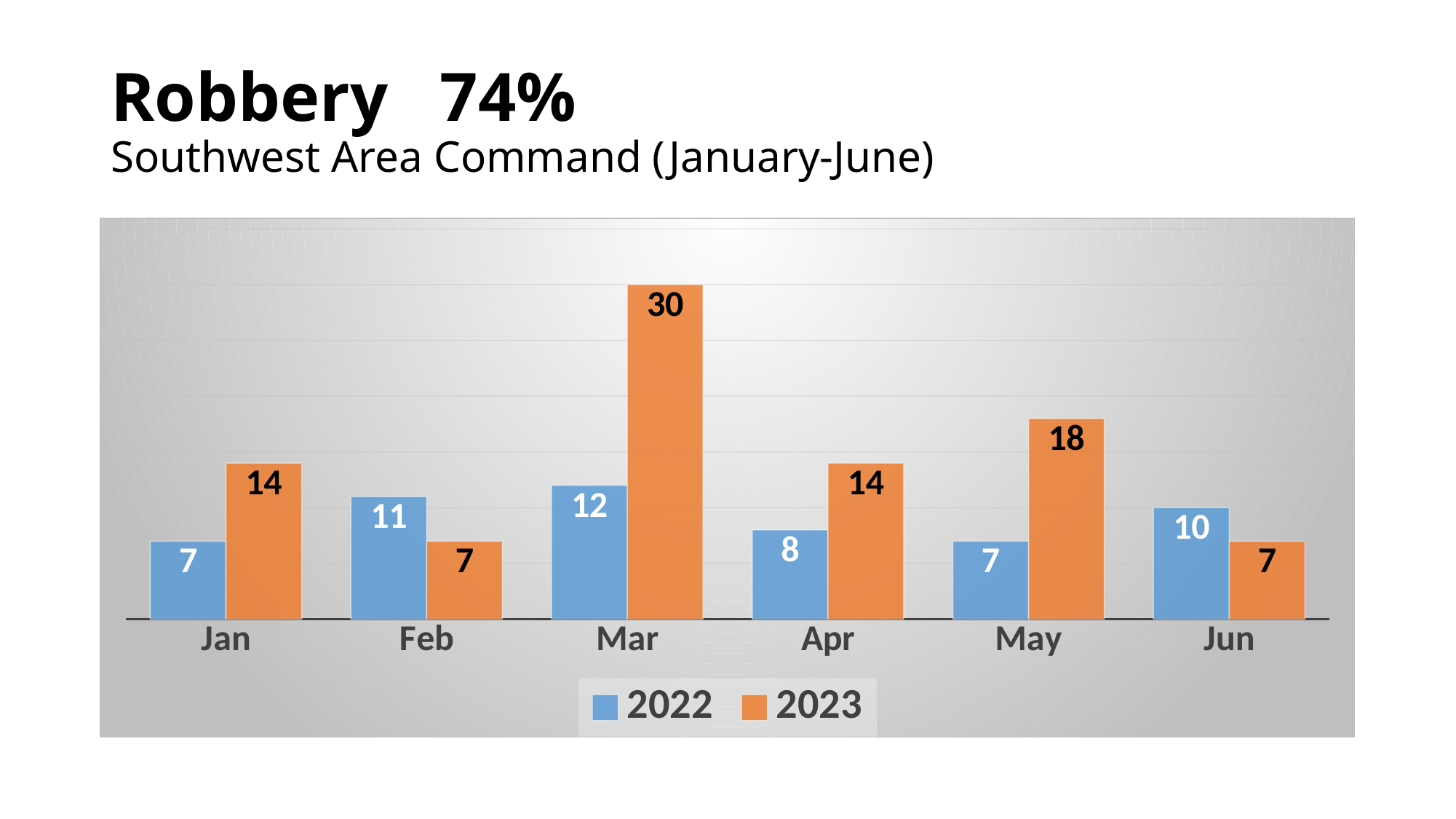
What is the difference between the 2022 and 2023 values in Feb? 4 Which is larger in Jun, the 2022 value or the 2023 value? 2022 What kind of chart is shown on the slide? Bar chart How many series does the legend list? 2 What is the value for 2022 in Feb? 11 Which month has the highest value for 2023? Mar What is the title of the chart? Robbery 74% Which month has the highest value for 2022? Mar How many months are shown on the x axis? 6 What is the difference between the 2023 and 2022 values in Mar? 18 What is the value for 2023 in Mar? 30 What is the value for 2023 in May? 18